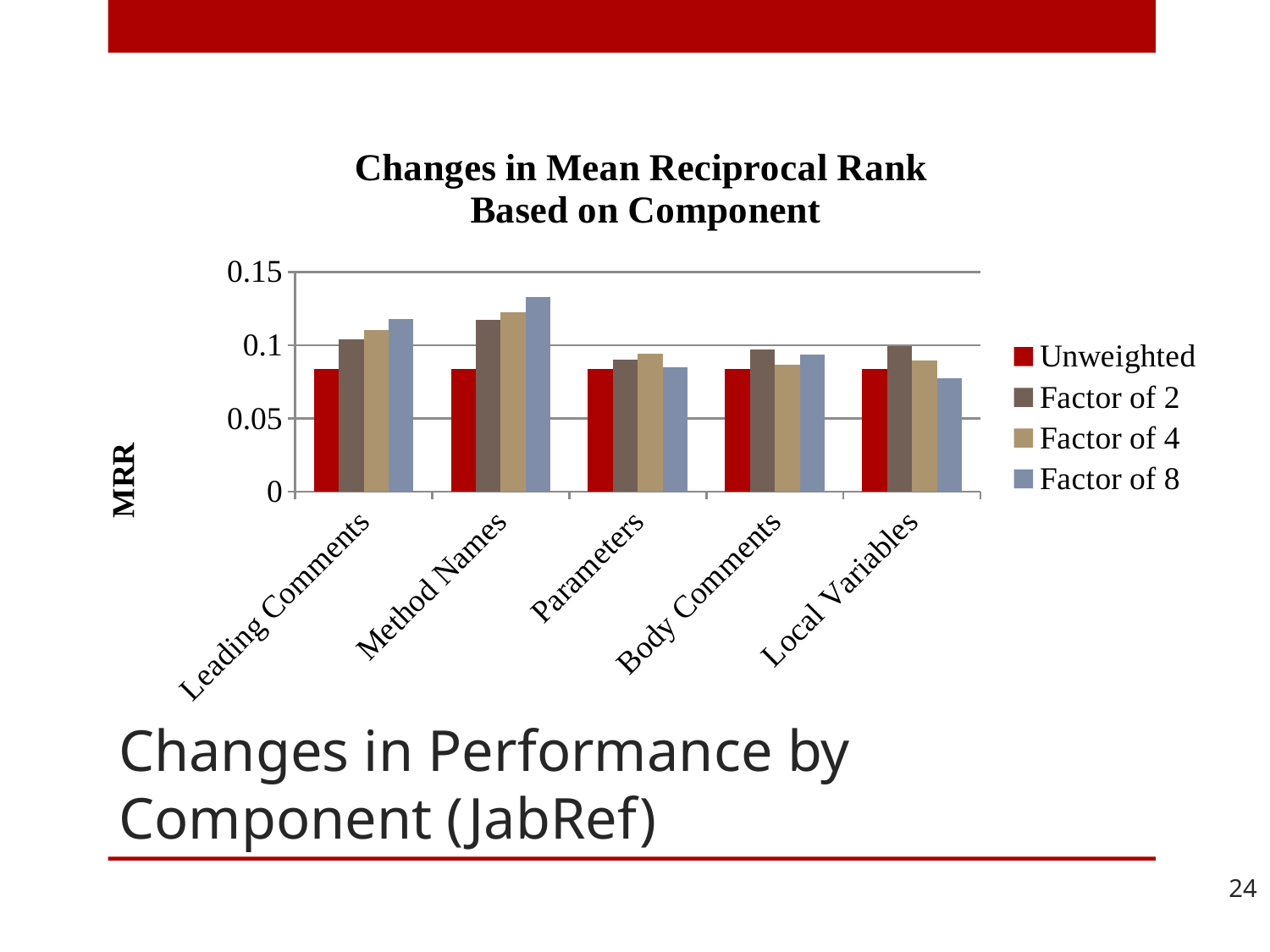
Is the Factor of 8 value for Method Names greater or less than 0.15? less Is the Factor of 4 value for Leading Comments greater or less than 0.1? greater What is the title of the chart? Changes in Mean Reciprocal Rank Based on Component How many series does the legend list? 4 Is the Factor of 8 value for Local Variables greater or less than 0.1? less What kind of chart is shown on the slide? Bar chart Which component has the highest Factor of 8 value? Method Names Which is larger, the Factor of 8 value for Method Names or for Leading Comments? Method Names What is the label on the vertical axis? MRR How many component categories are shown on the x axis? 5